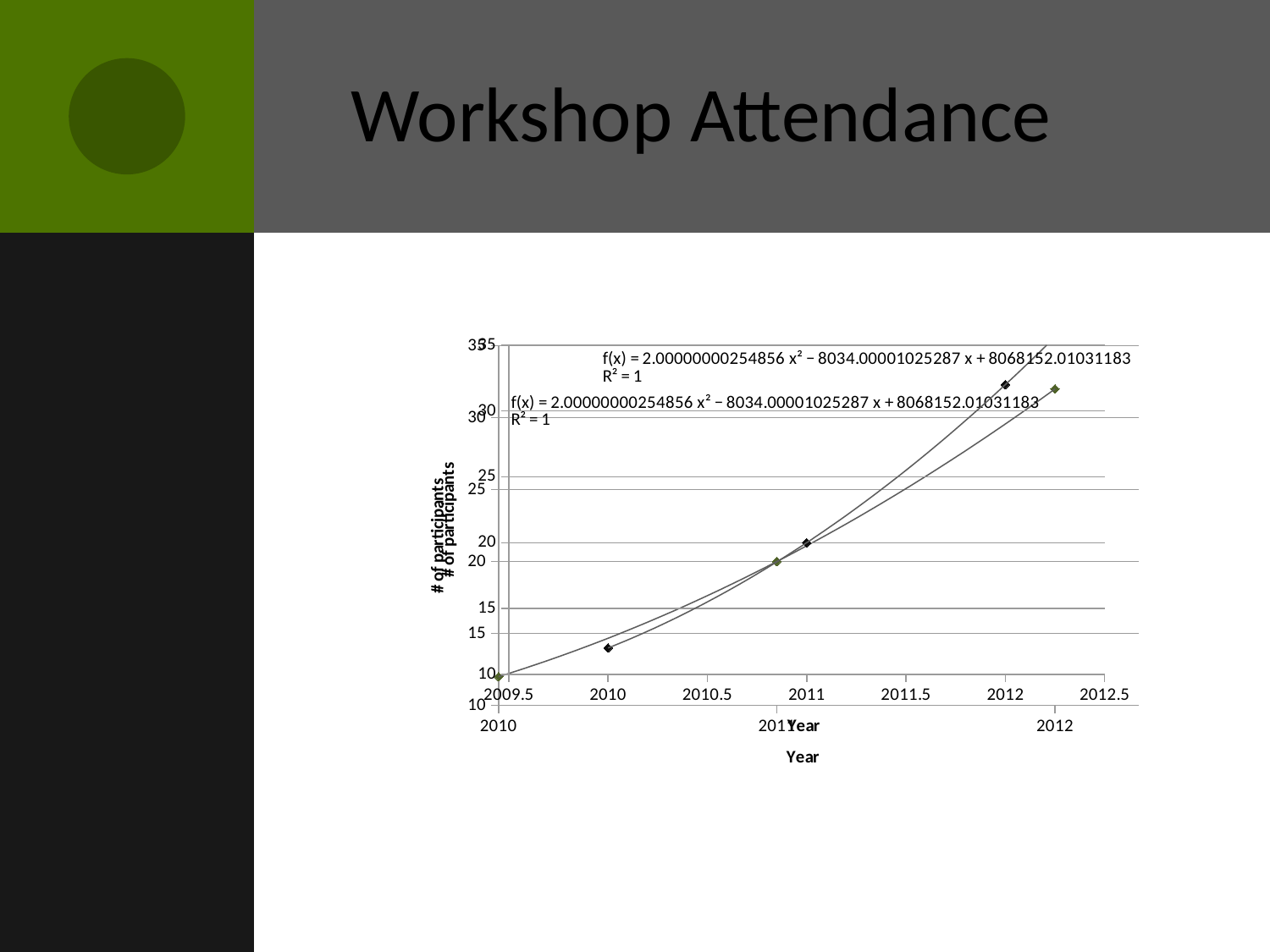
Is the number of participants for 2010 greater or less than 15? less Is the number of participants for 2011 greater or less than 25? less What kind of chart is shown on the slide? scatter chart with a trendline What R² value is shown for the trendline? R² = 1 Which year has more participants, 2011 or 2012? 2012 Is the number of participants for 2012 greater or less than 30? greater Which year has the highest number of participants? 2012 What is the label on the x axis of the chart? Year Which year has the lowest number of participants? 2010 Do the number of participants rise or fall from 2010 to 2012? rise